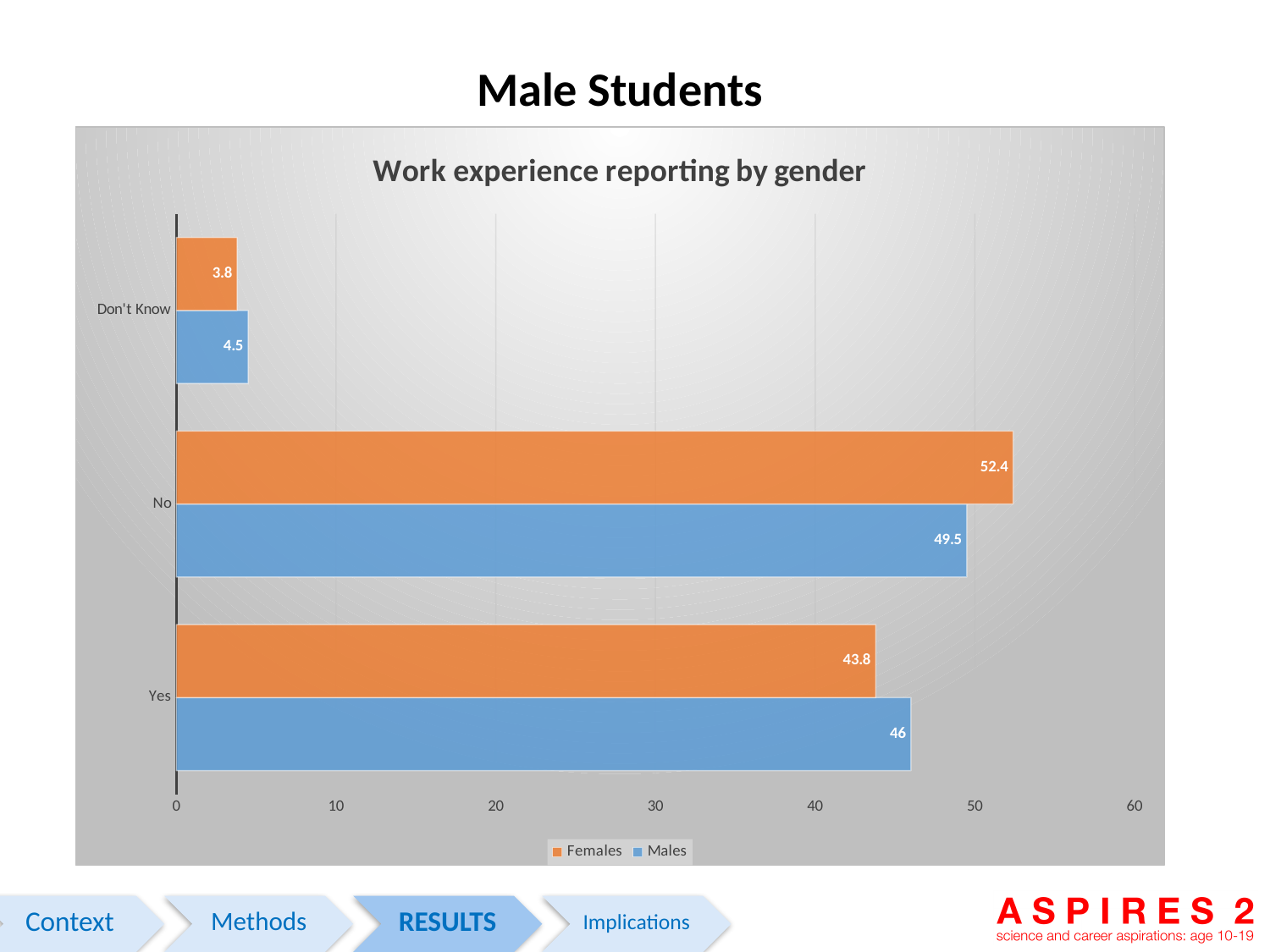
What is the difference between the Females and Males values in the 'No' category? 2.9 What is the value for Females in the 'Don't Know' category? 3.8 Which category has the highest value for Males? No Which category has the lowest value for Females? Don't Know What kind of chart is shown on the slide? Bar chart What is the value for Females in the 'No' category? 52.4 What is the value for Males in the 'Don't Know' category? 4.5 What is the title of the chart? Work experience reporting by gender How many series does the legend list? 2 What is the value for Males in the 'Yes' category? 46 How many categories are shown on the chart? 3 In the 'Yes' category, which series has the larger value, Females or Males? Males